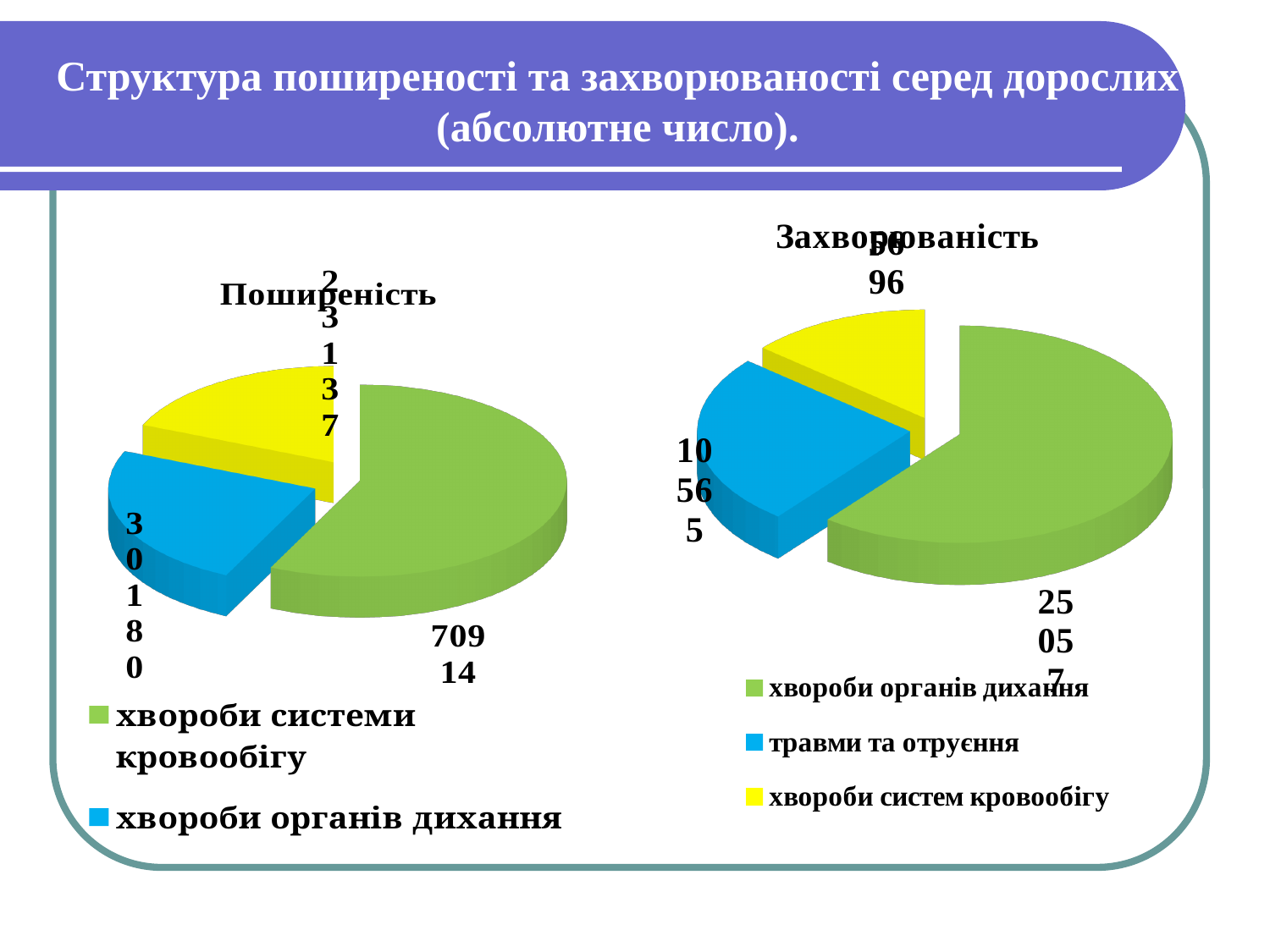
In the 'Захворюваність' chart, what is the value for хвороби органів дихання? 25057 In the 'Захворюваність' chart, what is the value for травми та отруєння? 10565 In the 'Захворюваність' chart, which category has the smallest slice? хвороби систем кровообігу In the 'Поширеність' chart, which category has the largest slice? хвороби системи кровообігу How many entries does the legend of the 'Захворюваність' chart list? 3 In the 'Захворюваність' chart, which category has the largest slice? хвороби органів дихання What kind of chart is the 'Поширеність' chart? pie chart In the 'Поширеність' chart, what is the difference between хвороби системи кровообігу and хвороби органів дихання? 40734 In the 'Поширеність' chart, which is larger: хвороби системи кровообігу or хвороби органів дихання? хвороби системи кровообігу In the 'Поширеність' chart, what is the value for хвороби системи кровообігу? 70914 In the 'Захворюваність' chart, what is the difference between хвороби органів дихання and травми та отруєння? 14492 In the 'Поширеність' chart, what is the value for хвороби органів дихання? 30180